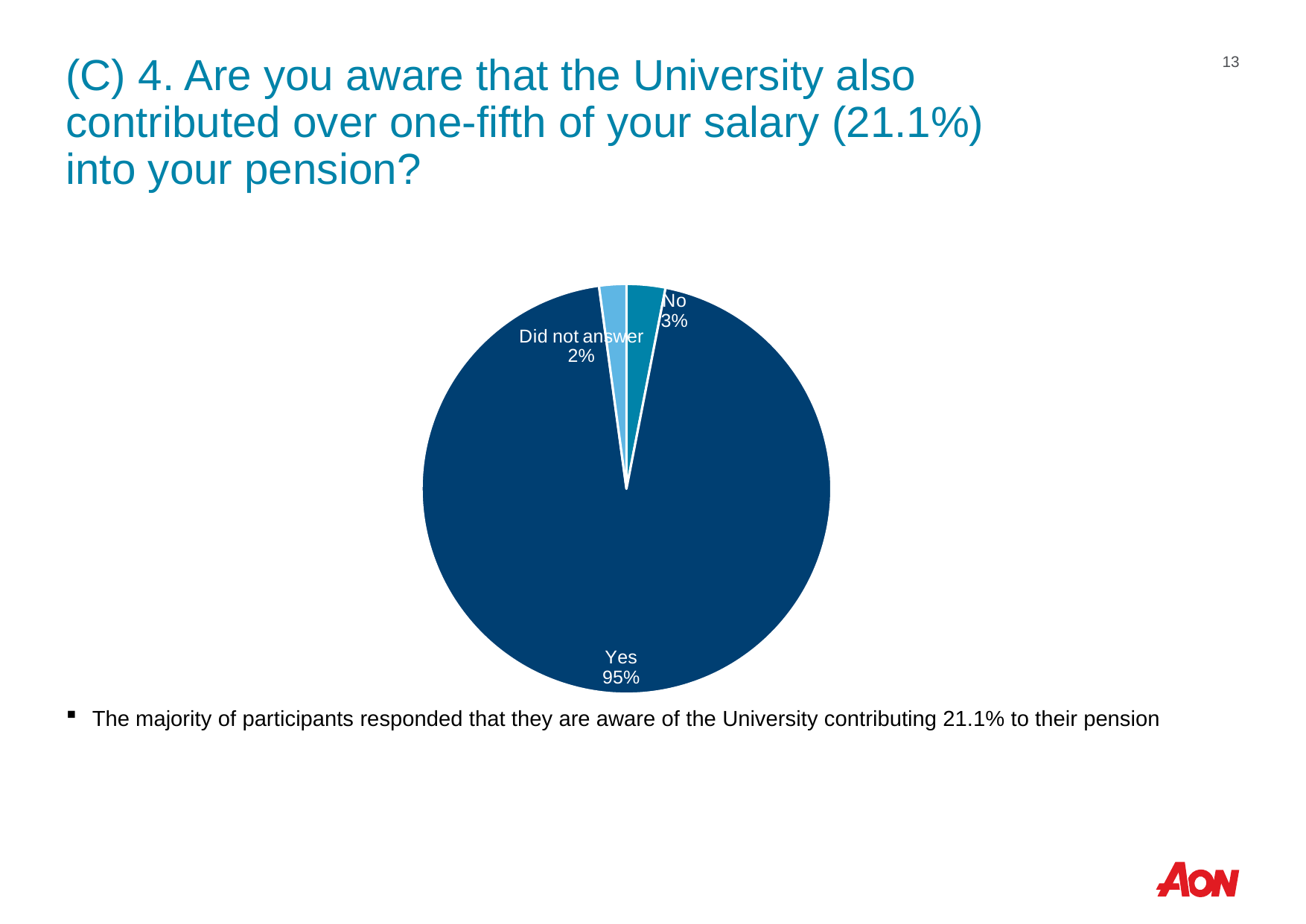
Which is larger, the share for No or the share for Did not answer? No What is the combined share of the No and Did not answer slices? 5% What colour is the Yes slice of the pie? dark blue What kind of chart is shown on the slide? pie chart Which response has the smallest share of the pie? Did not answer Which response has the largest share of the pie? Yes What percentage of participants answered No? 3% What is the difference in percentage points between the No and Did not answer responses? 1 What percentage of participants did not answer? 2% How many slices does the pie chart have? 3 What is the difference in percentage points between the Yes and No responses? 92 What percentage of participants answered Yes? 95%